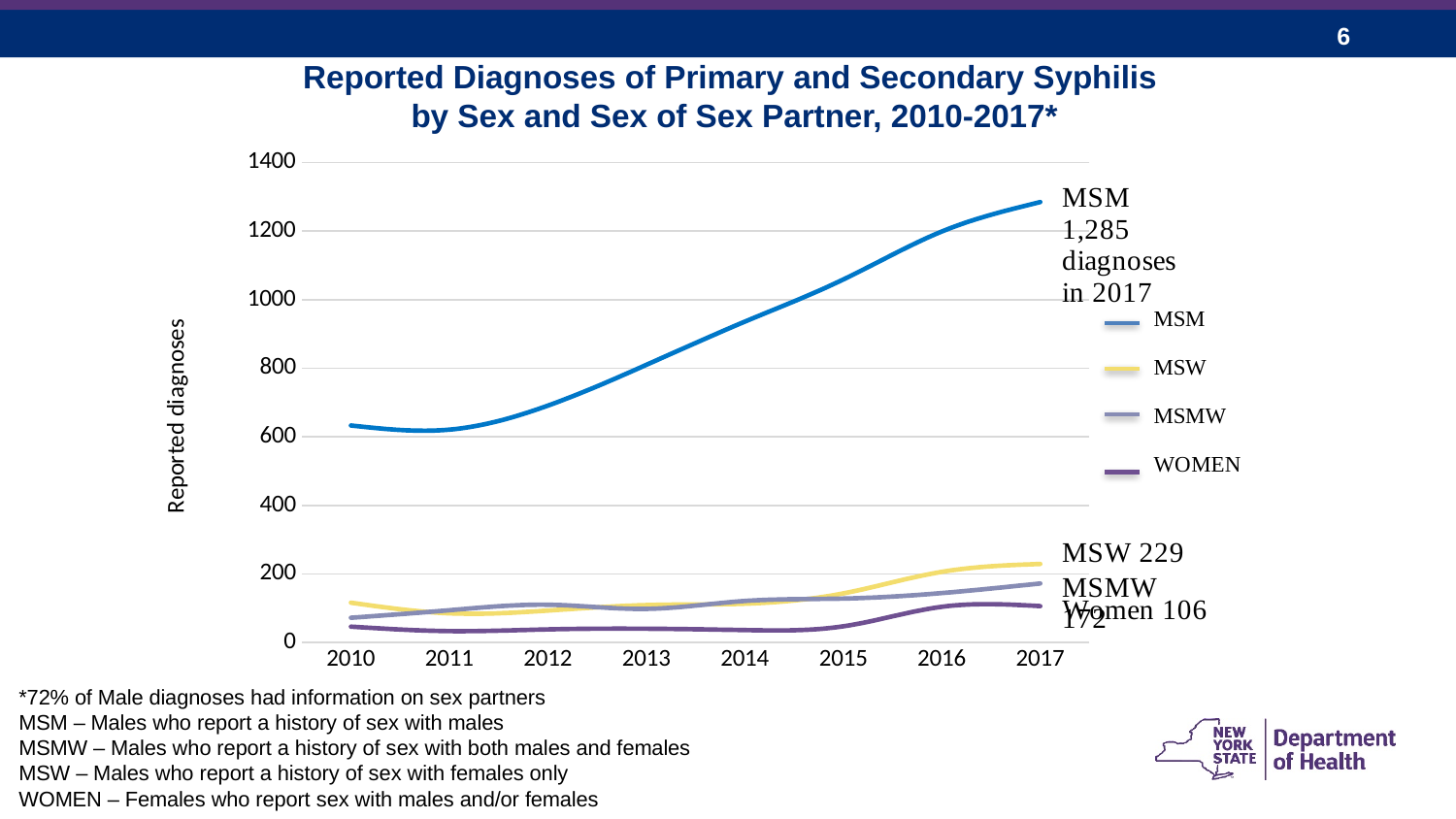
Does the MSM line rise or fall from 2011 to 2017? rise How many series does the legend list? 4 How many diagnoses among women were reported in 2017? 106 What type of chart is shown on the slide? line chart How many years are shown along the x axis? 8 Is the number of MSM diagnoses in 2010 greater or less than 800? less How many MSW diagnoses were reported in 2017? 229 In 2017, which is larger: MSW diagnoses or diagnoses among women? MSW Which group had the lowest number of reported diagnoses in 2017? WOMEN What is the difference between MSM and MSW diagnoses in 2017? 1,056 How many MSM diagnoses were reported in 2017? 1,285 Which group had the highest number of reported diagnoses in 2017? MSM